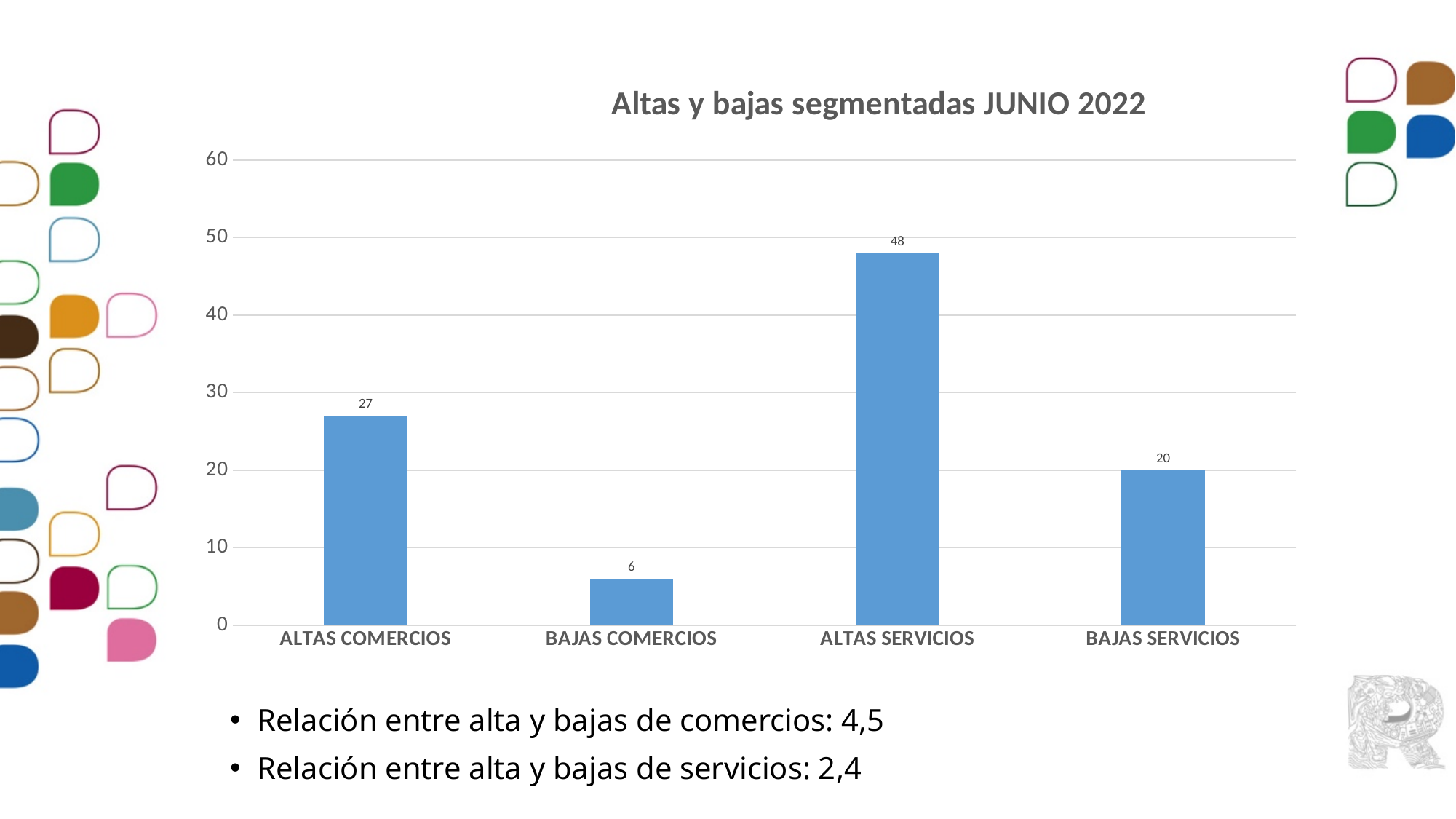
What is the value for BAJAS COMERCIOS? 6 Which category has the highest value? ALTAS SERVICIOS What is the difference between ALTAS SERVICIOS and BAJAS SERVICIOS? 28 What kind of chart is shown on the slide? bar chart What is the value for ALTAS COMERCIOS? 27 What is the difference between ALTAS COMERCIOS and BAJAS COMERCIOS? 21 How many categories are shown on the x axis? 4 What is the value for ALTAS SERVICIOS? 48 Which category has the lowest value? BAJAS COMERCIOS What is the value for BAJAS SERVICIOS? 20 Which is larger, ALTAS COMERCIOS or BAJAS SERVICIOS? ALTAS COMERCIOS What is the title of the chart? Altas y bajas segmentadas JUNIO 2022